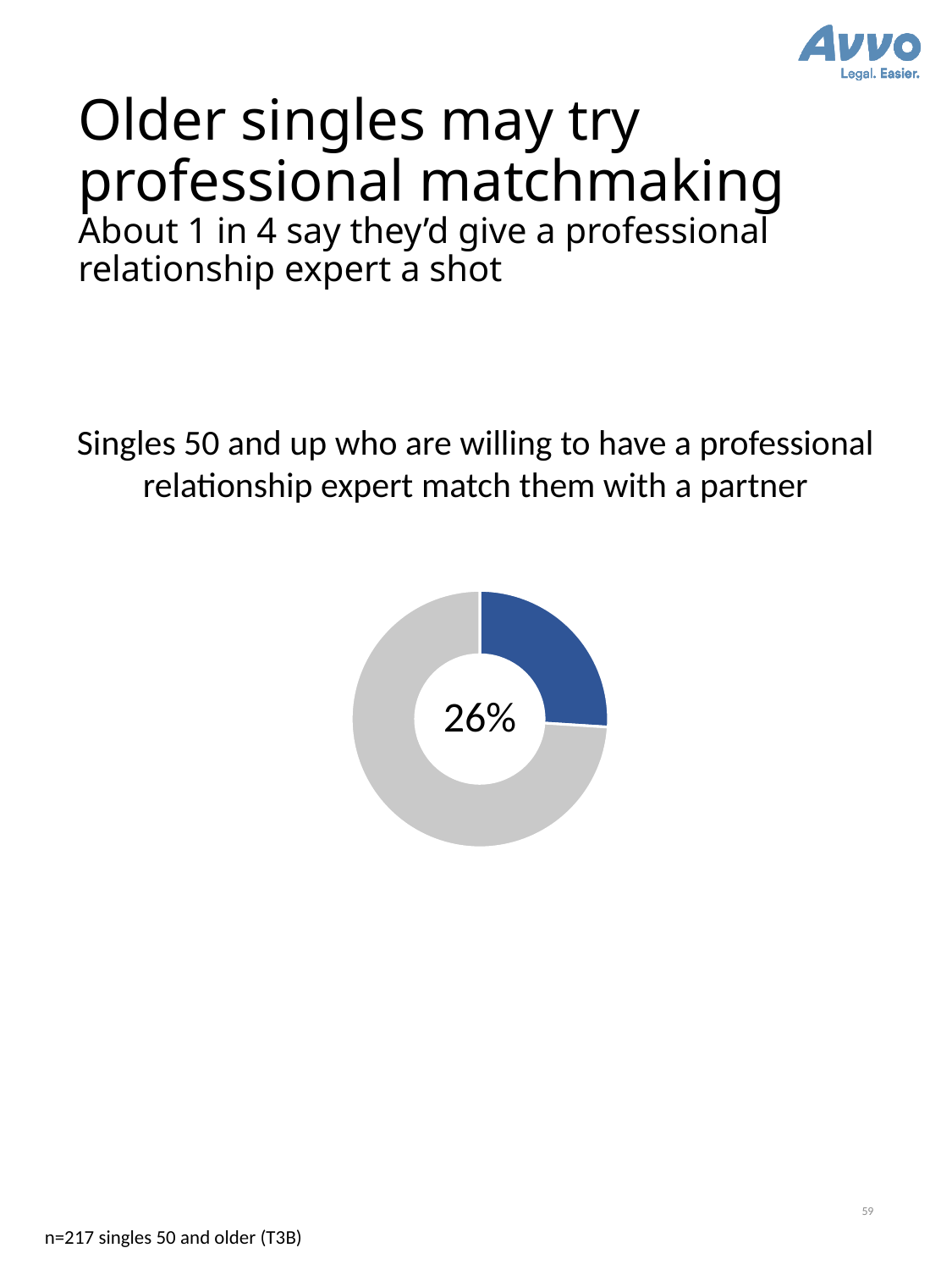
Which slice of the donut chart is larger, the blue slice or the grey slice? The grey slice Is the blue slice of the donut chart greater or less than 50% of the whole? less What is the title of the chart on the slide? Singles 50 and up who are willing to have a professional relationship expert match them with a partner What percentage is shown in the centre of the donut chart? 26% Is the grey slice of the donut chart greater or less than 50% of the whole? greater What share of singles 50 and up are willing to have a professional relationship expert match them with a partner, according to the chart? 26% What is the sample size noted at the bottom of the slide for the chart? n=217 singles 50 and older (T3B) How many slices does the donut chart have? 2 What colour is the slice representing the 26% of singles willing to use a professional relationship expert? Blue What kind of chart is shown on the slide? Donut chart